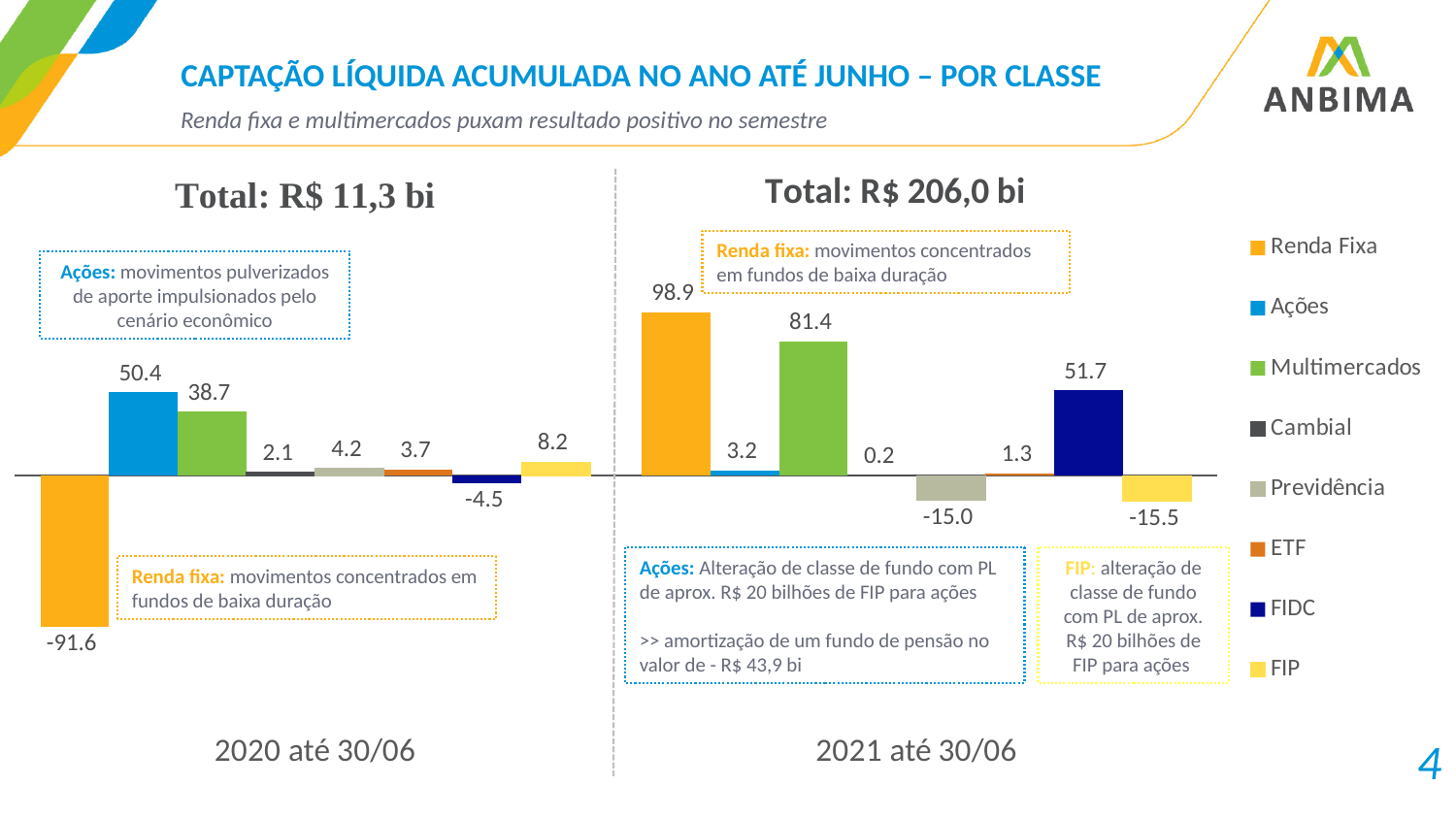
In the 2021 até 30/06 chart, which class has the highest value? Renda Fixa In the 2021 até 30/06 chart, what is the value for Multimercados? 81.4 In the 2020 até 30/06 chart, what is the value for Ações? 50.4 How many series does the legend list? 8 In the 2021 até 30/06 chart, what is the difference between Renda Fixa and Multimercados? 17.5 What total is shown above the 2021 até 30/06 chart? R$ 206,0 bi In the 2021 até 30/06 chart, what is the value for FIDC? 51.7 What kind of chart is used for the 2021 até 30/06 data? Bar chart In the 2020 até 30/06 chart, which is larger, Ações or Multimercados? Ações In the 2020 até 30/06 chart, which class has the lowest value? Renda Fixa In the 2021 até 30/06 chart, which class has the lowest value? FIP In the 2020 até 30/06 chart, what is the value for Renda Fixa? -91.6